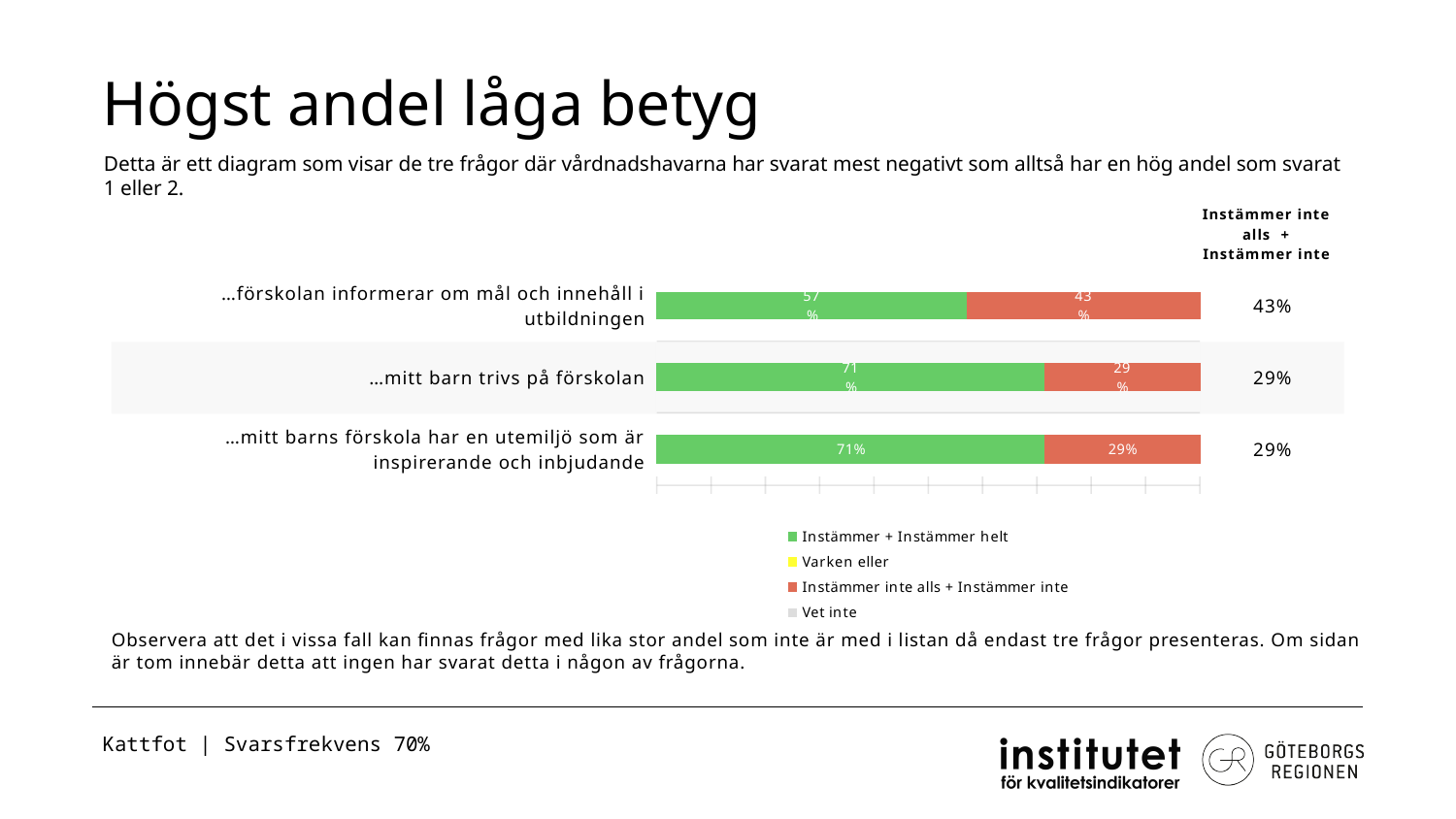
What is the difference between the "Instämmer + Instämmer helt" values for "…mitt barn trivs på förskolan" and "…förskolan informerar om mål och innehåll i utbildningen"? 14% What is the title of the chart slide? Högst andel låga betyg What is the value of "Instämmer inte alls + Instämmer inte" for "…mitt barns förskola har en utemiljö som är inspirerande och inbjudande"? 29% What is the total of the stacked bar for "…mitt barns förskola har en utemiljö som är inspirerande och inbjudande"? 100% Which is larger: the "Instämmer inte alls + Instämmer inte" value for "…förskolan informerar om mål och innehåll i utbildningen" or for "…mitt barn trivs på förskolan"? …förskolan informerar om mål och innehåll i utbildningen What is the value of "Instämmer inte alls + Instämmer inte" for "…förskolan informerar om mål och innehåll i utbildningen"? 43% How many series does the legend list? 4 What is the value of "Instämmer + Instämmer helt" for "…förskolan informerar om mål och innehåll i utbildningen"? 57% How many categories (questions) are plotted in the chart? 3 Which category has the highest share of "Instämmer inte alls + Instämmer inte"? …förskolan informerar om mål och innehåll i utbildningen What is the value of "Instämmer + Instämmer helt" for "…mitt barn trivs på förskolan"? 71% What kind of chart is shown on the slide? bar chart